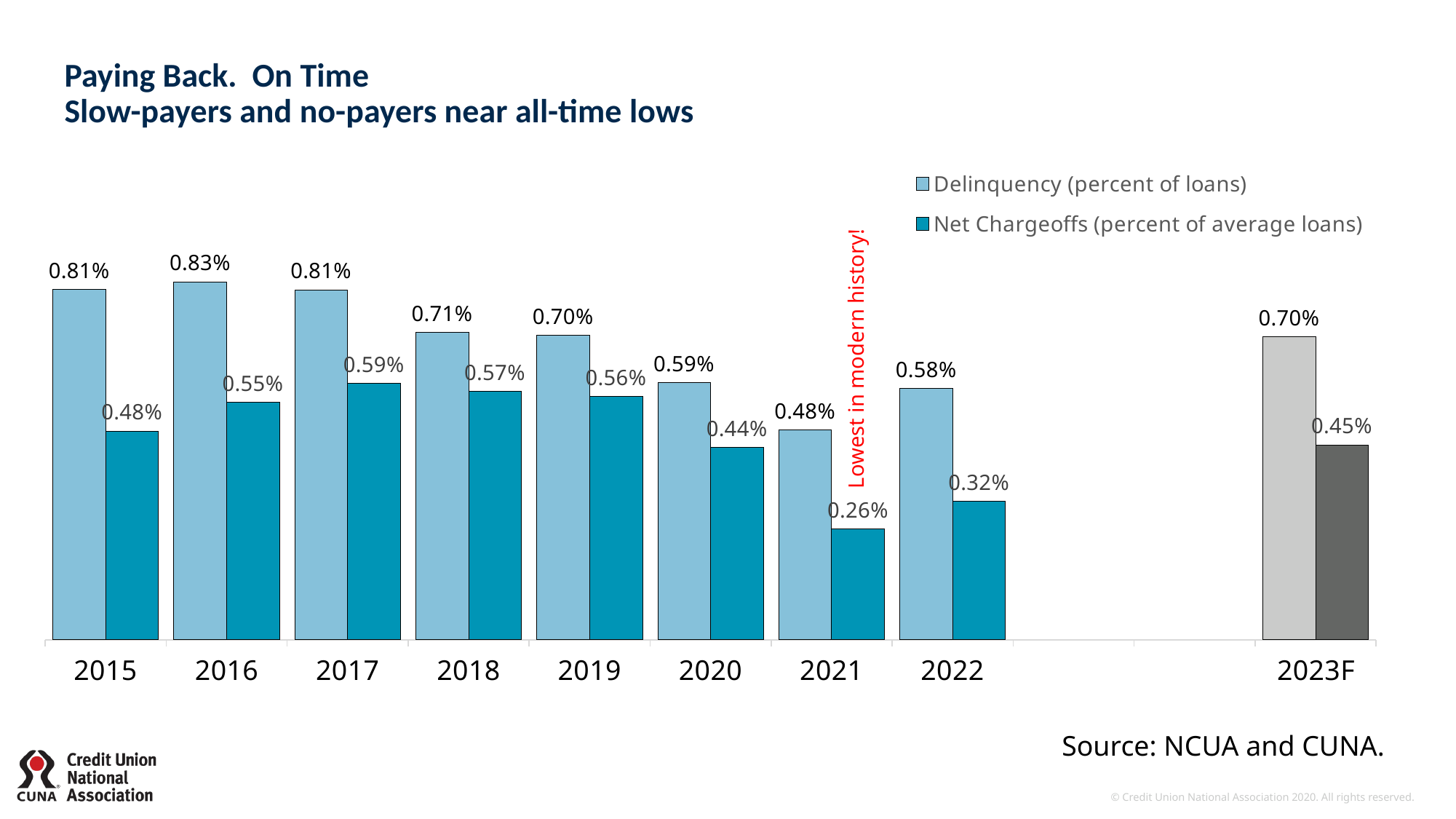
What kind of chart is shown on the slide? Bar chart What is the Delinquency (percent of loans) value for 2023F? 0.70% Which year has the lowest Net Chargeoffs (percent of average loans) value? 2021 Which is larger, the Net Chargeoffs value for 2020 or for 2022? 2020 What is the Net Chargeoffs (percent of average loans) value for 2018? 0.57% How many series does the legend list? 2 What is the Net Chargeoffs (percent of average loans) value for 2021? 0.26% What does the red annotation next to the 2021 bars say? Lowest in modern history! How many years are shown on the x axis? 9 What is the difference between the Delinquency and Net Chargeoffs values in 2015? 0.33% Which year has the highest Delinquency (percent of loans) value? 2016 What is the Delinquency (percent of loans) value for 2016? 0.83%